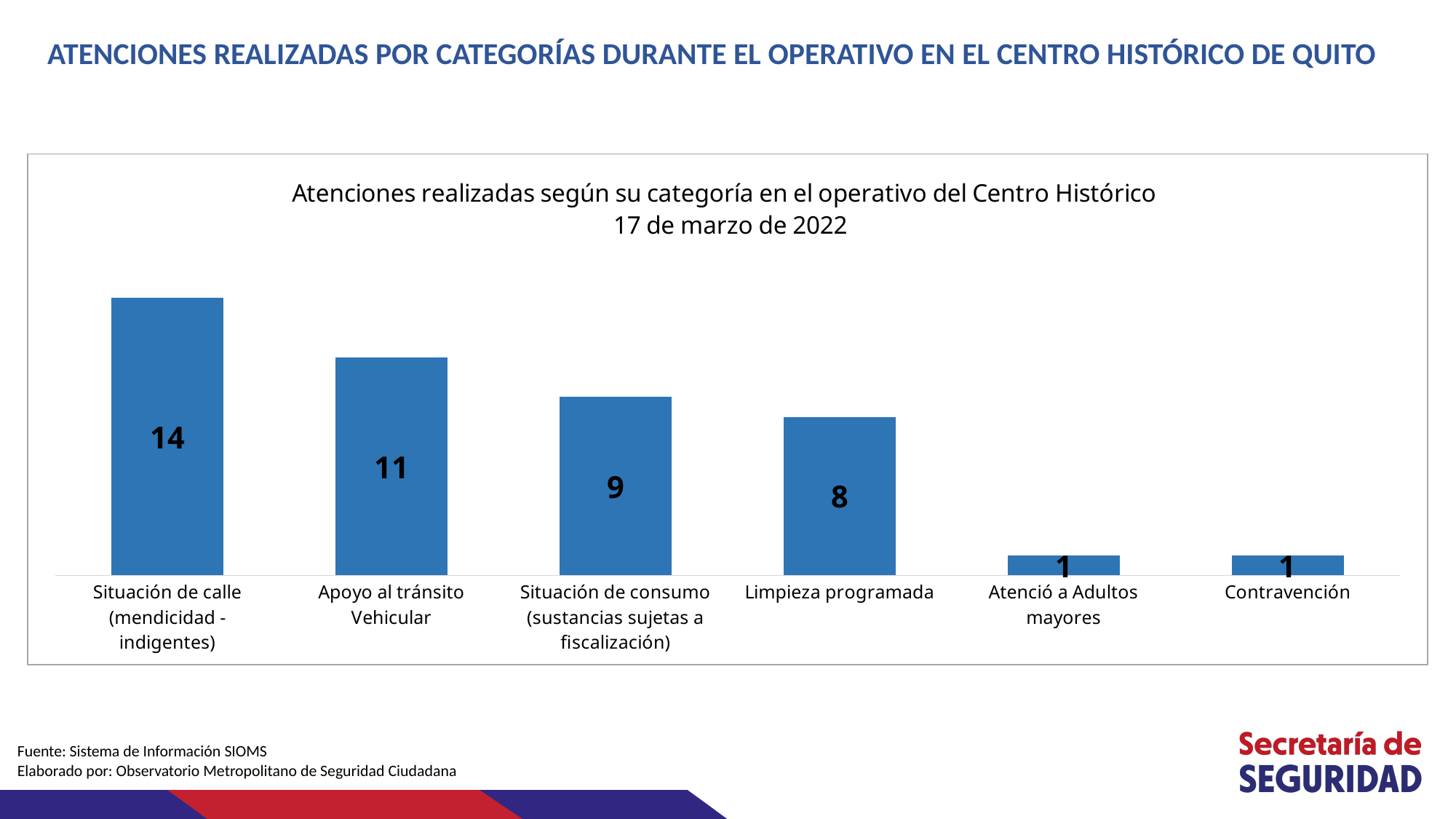
What is the value for Apoyo al tránsito Vehicular? 11 Which is larger, Apoyo al tránsito Vehicular or Limpieza programada? Apoyo al tránsito Vehicular What is the value for Contravención? 1 Which category has the highest value? Situación de calle (mendicidad - indigentes) Do the values rise or fall from left to right across the categories? Fall What is the difference between Situación de calle (mendicidad - indigentes) and Apoyo al tránsito Vehicular? 3 What date is given in the chart title? 17 de marzo de 2022 How many categories are shown in the chart? 6 What is the value for Limpieza programada? 8 What kind of chart is shown on the slide? Bar chart What is the difference between Situación de consumo (sustancias sujetas a fiscalización) and Limpieza programada? 1 What is the value for Situación de consumo (sustancias sujetas a fiscalización)? 9